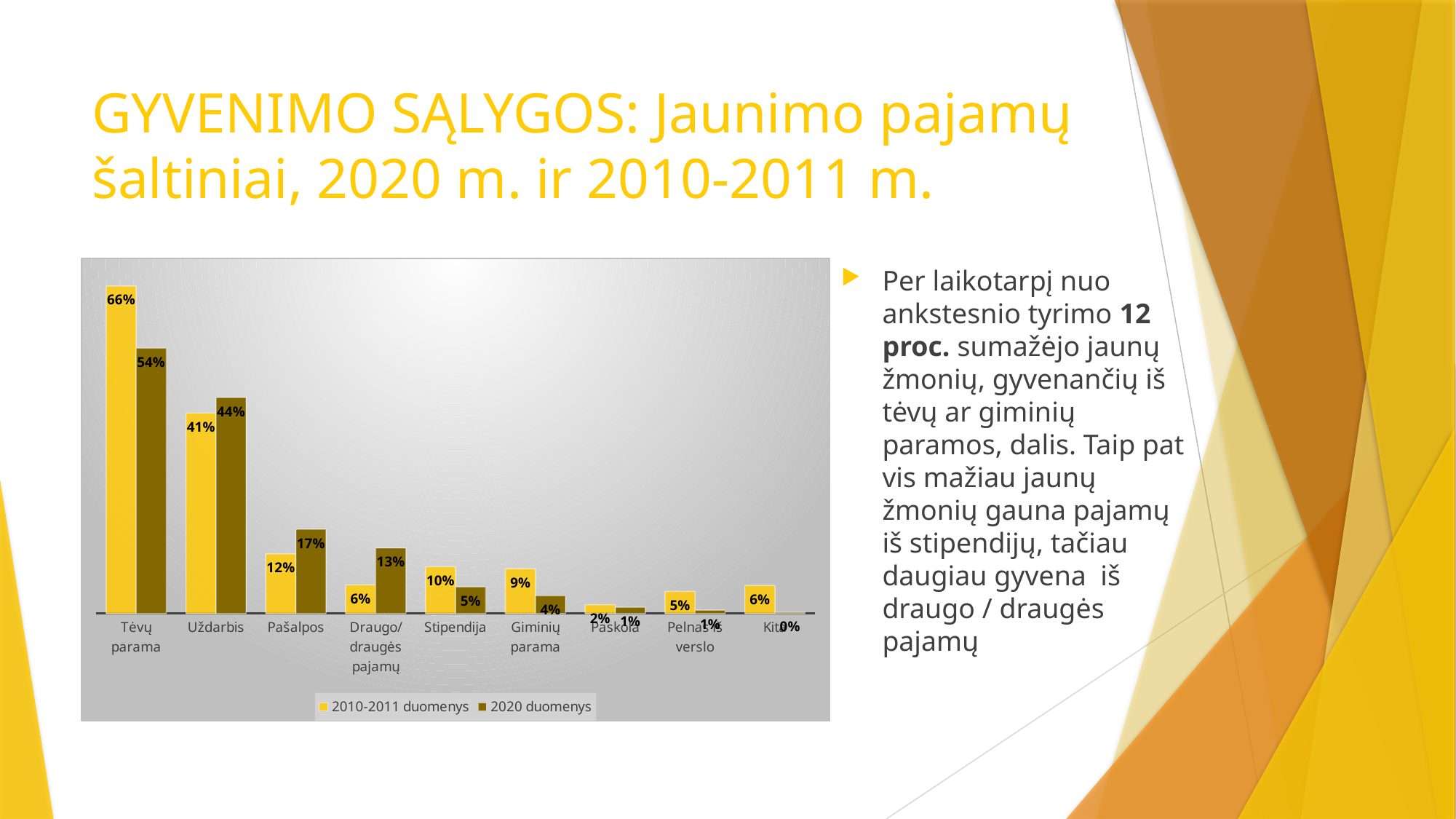
What is the difference between the 2010-2011 duomenys and 2020 duomenys values for Tėvų parama? 12% Which category has the highest value in the 2010-2011 duomenys series? Tėvų parama What is the value for Tėvų parama in the 2010-2011 duomenys series? 66% What is the value for Tėvų parama in the 2020 duomenys series? 54% What is the difference between the 2020 duomenys and 2010-2011 duomenys values for Pašalpos? 5% What kind of chart is shown on the slide? bar chart What is the value for Stipendija in the 2010-2011 duomenys series? 10% Which series is shown in the darker colour in the legend? 2020 duomenys For Draugo/draugės pajamų, which series has the larger value, 2010-2011 duomenys or 2020 duomenys? 2020 duomenys How many series does the legend list? 2 How many categories are shown on the x axis? 9 What is the value for Uždarbis in the 2020 duomenys series? 44%